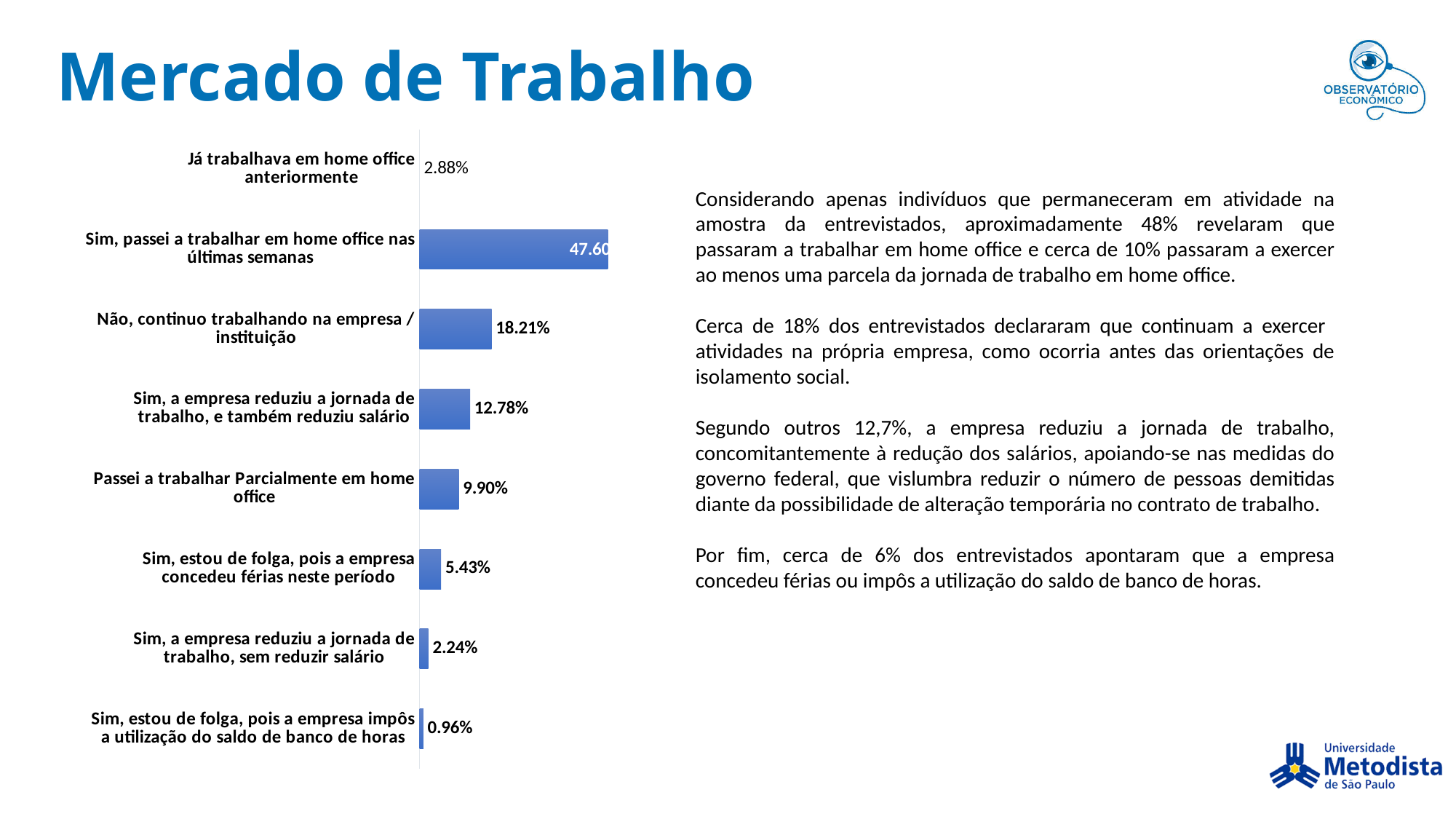
How many categories are shown in the chart? 8 What is the value for "Já trabalhava em home office anteriormente"? 2.88% What is the value for "Não, continuo trabalhando na empresa / instituição"? 18.21% Which category has the highest value? Sim, passei a trabalhar em home office nas últimas semanas What is the value for "Sim, a empresa reduziu a jornada de trabalho, e também reduziu salário"? 12.78% Which category has the lowest value? Sim, estou de folga, pois a empresa impôs a utilização do saldo de banco de horas What is the difference between the values for "Não, continuo trabalhando na empresa / instituição" and "Sim, a empresa reduziu a jornada de trabalho, e também reduziu salário"? 5.43% What is the value for "Sim, estou de folga, pois a empresa concedeu férias neste período"? 5.43% Which is larger: the value for "Já trabalhava em home office anteriormente" or for "Sim, a empresa reduziu a jornada de trabalho, sem reduzir salário"? Já trabalhava em home office anteriormente What kind of chart is shown on the slide? Bar chart What is the value for "Passei a trabalhar Parcialmente em home office"? 9.90% What is the value for "Sim, a empresa reduziu a jornada de trabalho, sem reduzir salário"? 2.24%